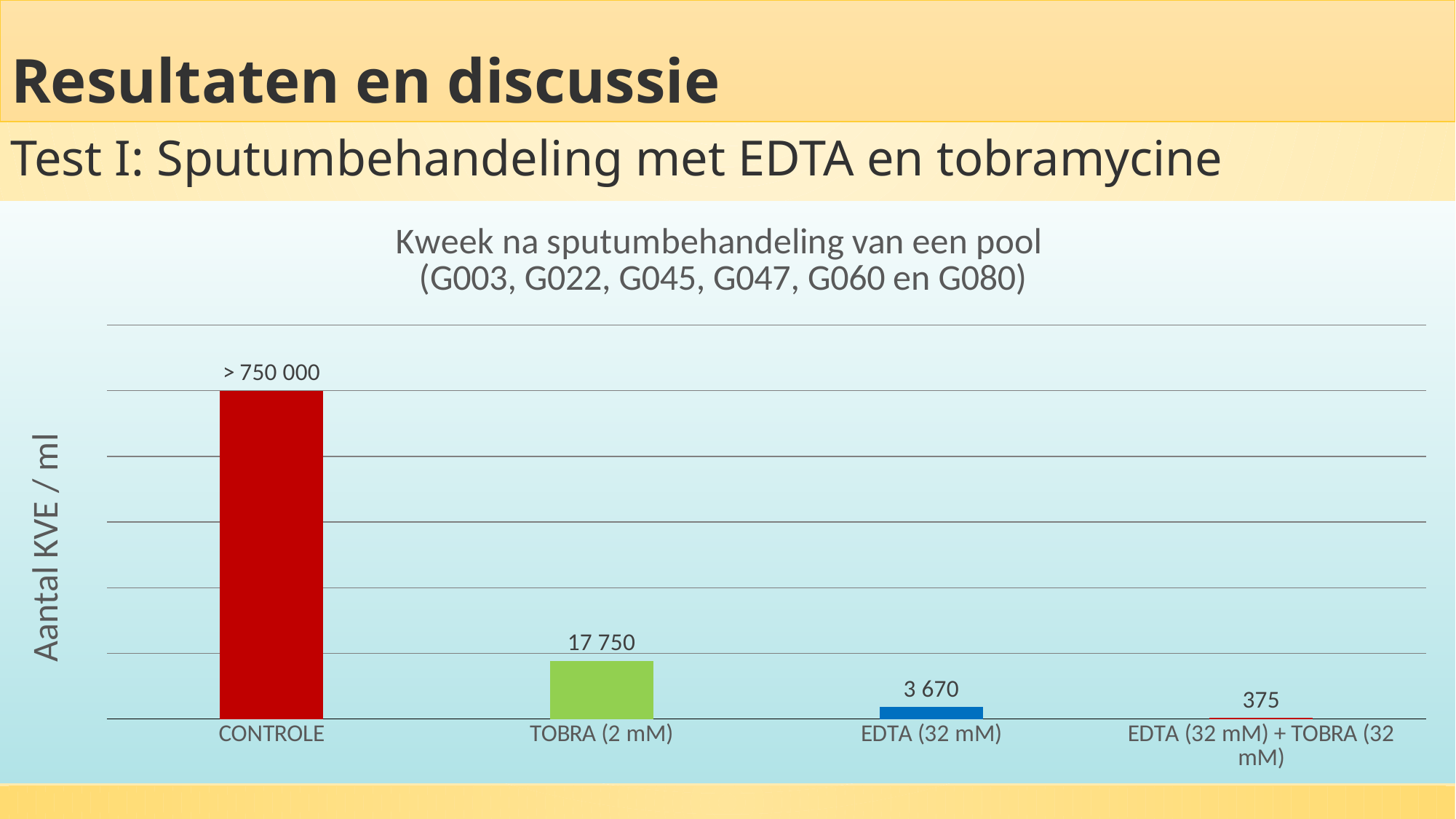
Which is larger, the value for TOBRA (2 mM) or the value for EDTA (32 mM)? TOBRA (2 mM) Which category has the lowest value? EDTA (32 mM) + TOBRA (32 mM) What is the label of the vertical axis? Aantal KVE / ml What is the value shown for TOBRA (2 mM)? 17 750 What is the value shown for EDTA (32 mM)? 3 670 What data label is shown above the CONTROLE bar? > 750 000 What is the difference between the values for EDTA (32 mM) and EDTA (32 mM) + TOBRA (32 mM)? 3 295 What is the value shown for EDTA (32 mM) + TOBRA (32 mM)? 375 What kind of chart is shown on the slide? Bar chart What is the difference between the values for TOBRA (2 mM) and EDTA (32 mM)? 14 080 Which category has the highest value? CONTROLE How many categories are shown on the x axis? 4